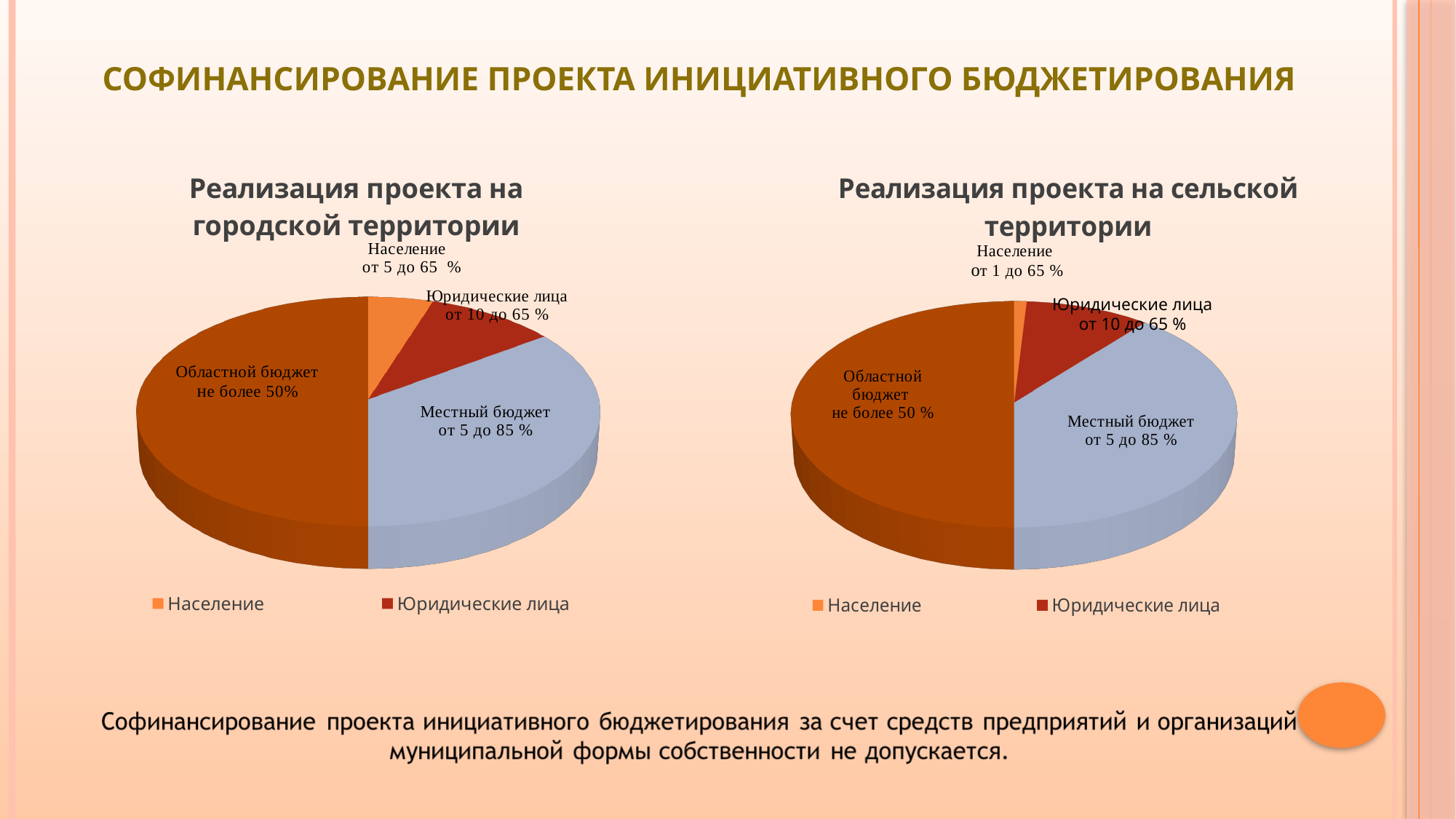
In the chart 'Реализация проекта на городской территории', what limit is printed for 'Областной бюджет'? не более 50% How many slices does the pie chart 'Реализация проекта на сельской территории' have? 4 What type of chart is used for 'Реализация проекта на городской территории'? Pie chart In the chart 'Реализация проекта на сельской территории', what range is printed for 'Юридические лица'? от 10 до 65 % How many entries does the legend of the left chart ('Реализация проекта на городской территории') list? 2 Which slice is the largest in the chart 'Реализация проекта на сельской территории'? Областной бюджет In the chart 'Реализация проекта на сельской территории', what range is printed for the 'Население' slice? от 1 до 65 % In the chart 'Реализация проекта на городской территории', which slice is larger: 'Юридические лица' or 'Местный бюджет'? Местный бюджет In the chart 'Реализация проекта на городской территории', what range is printed for the 'Население' slice? от 5 до 65 % In the chart 'Реализация проекта на сельской территории', what range is printed for 'Местный бюджет'? от 5 до 85 % Which legend entry is shown in orange in the right chart ('Реализация проекта на сельской территории')? Население Which slice is the smallest in the chart 'Реализация проекта на городской территории'? Население